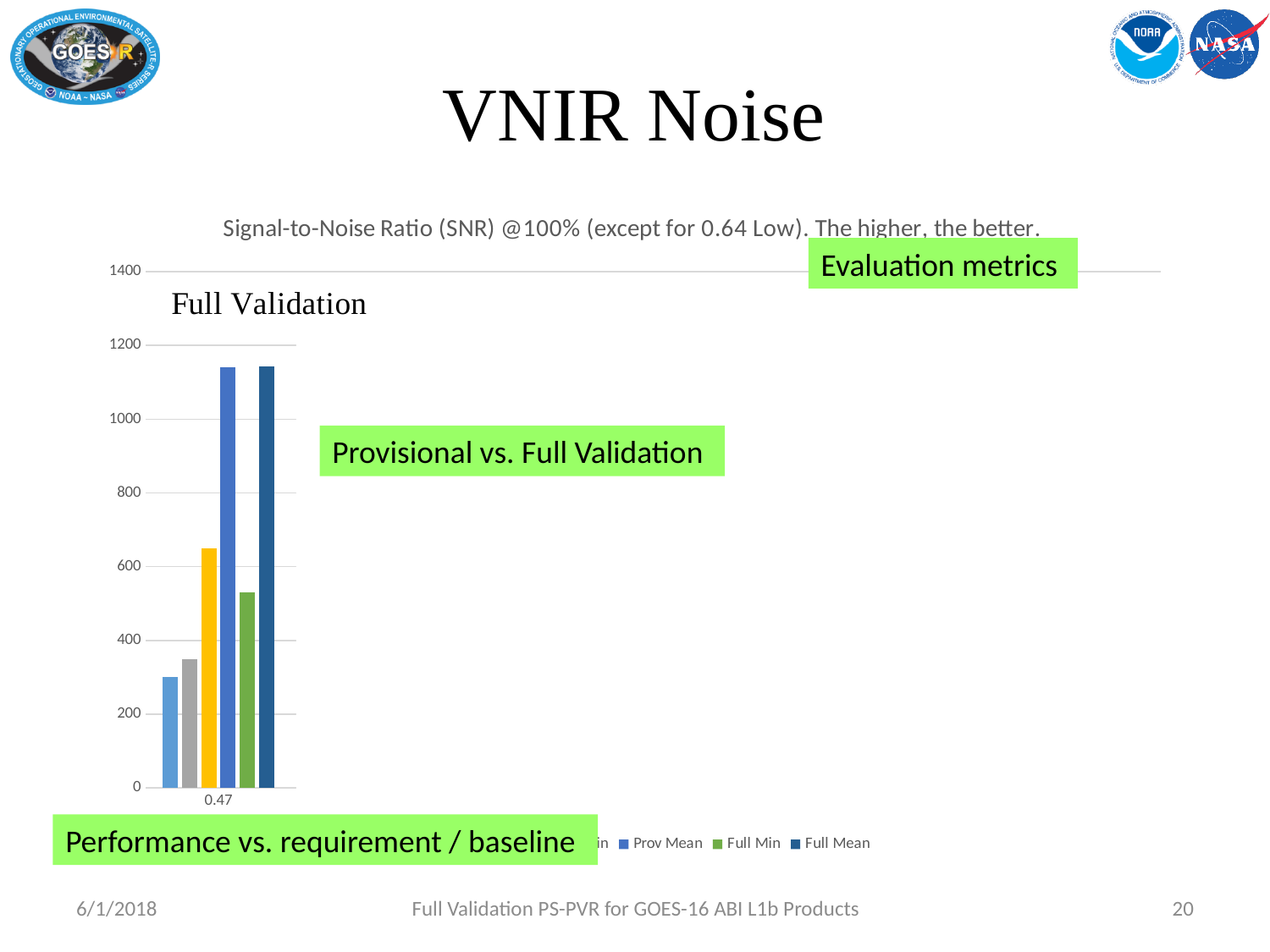
Is the value of the Full Mean bar for 0.47 greater or less than 1200? less How many categories are shown on the x axis of the chart? 1 Is the value of the Full Mean bar for 0.47 greater or less than 1000? greater What kind of chart is shown on the slide? bar chart Is the value of the Full Min bar for 0.47 greater or less than 600? less For the 0.47 category, which is larger, the Full Mean bar or the Full Min bar? Full Mean What is the title of the chart? Signal-to-Noise Ratio (SNR) @100% (except for 0.64 Low). The higher, the better. For the 0.47 category, which is larger, the Prov Mean bar or the Full Min bar? Prov Mean What is the highest value shown on the y axis of the chart? 1400 What is the label of the category shown on the x axis? 0.47